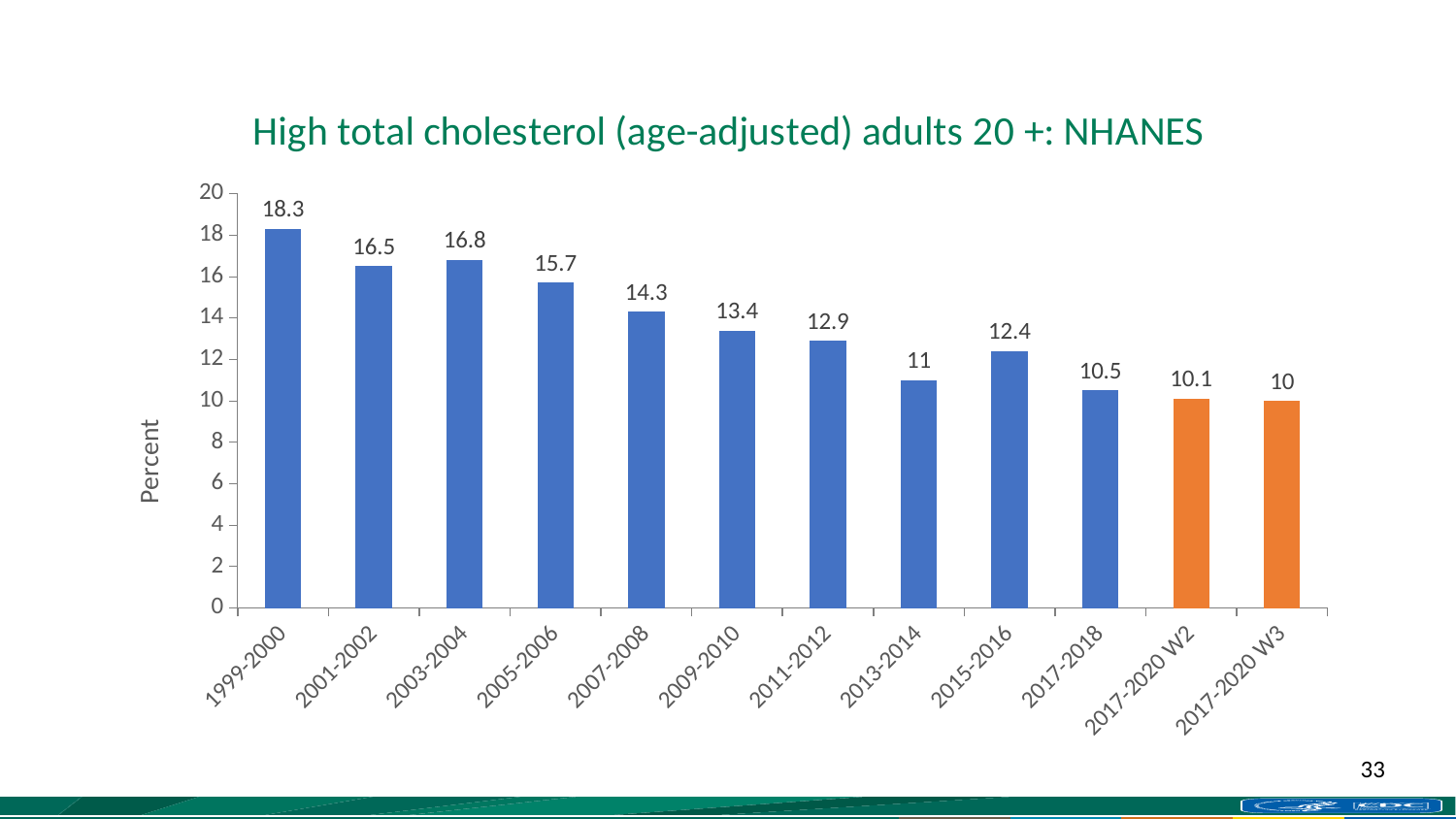
What is the difference between the values for 1999-2000 and 2017-2018? 7.8 What is the value for 1999-2000? 18.3 What is the value for 2013-2014? 11 What kind of chart is this? bar chart Which period has the lowest value? 2017-2020 W3 Is the value for 2007-2008 greater or less than 14? greater How many periods are shown on the x axis? 12 What is the label of the y axis? Percent Which is larger, the value for 2001-2002 or the value for 2003-2004? 2003-2004 What is the value for 2017-2020 W3? 10 Do the values generally rise or fall from 1999-2000 to 2017-2020 W3? fall Which period has the highest value? 1999-2000